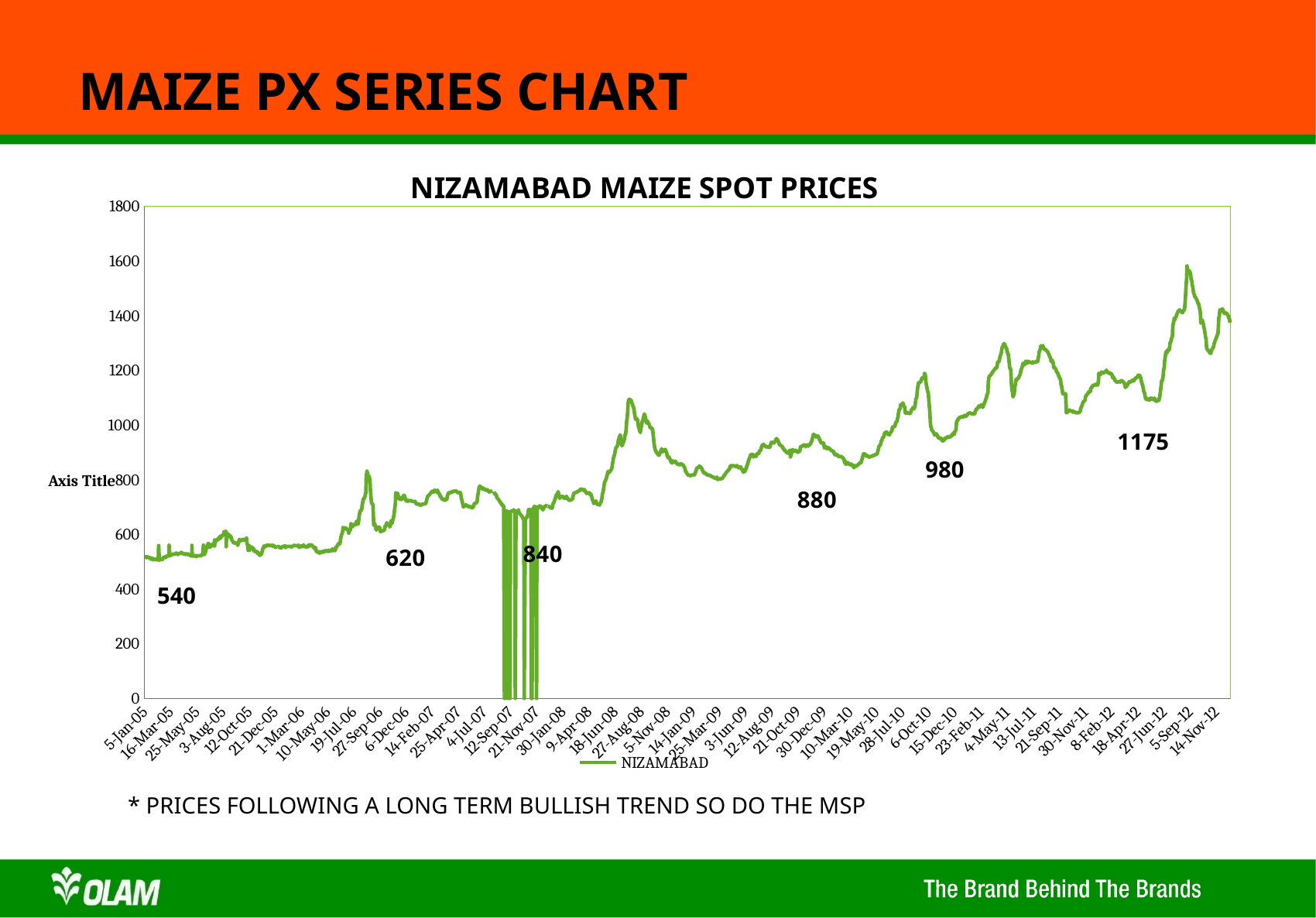
What kind of chart is shown on the slide? Line chart What is the title of the chart? NIZAMABAD MAIZE SPOT PRICES How many series does the chart's legend list? 1 Is the value for 30-Dec-09 greater or less than 800? greater Which is larger, the value for 5-Jan-05 or the value for 14-Nov-12? 14-Nov-12 Is the value for 1-Mar-06 greater or less than 800? less What is the name of the series shown in the legend? NIZAMABAD Overall, do the Nizamabad maize spot prices rise or fall from 2005 to 2012? Rise Is the value for 5-Jan-05 greater or less than 600? less In which year does the series reach its highest value? 2012